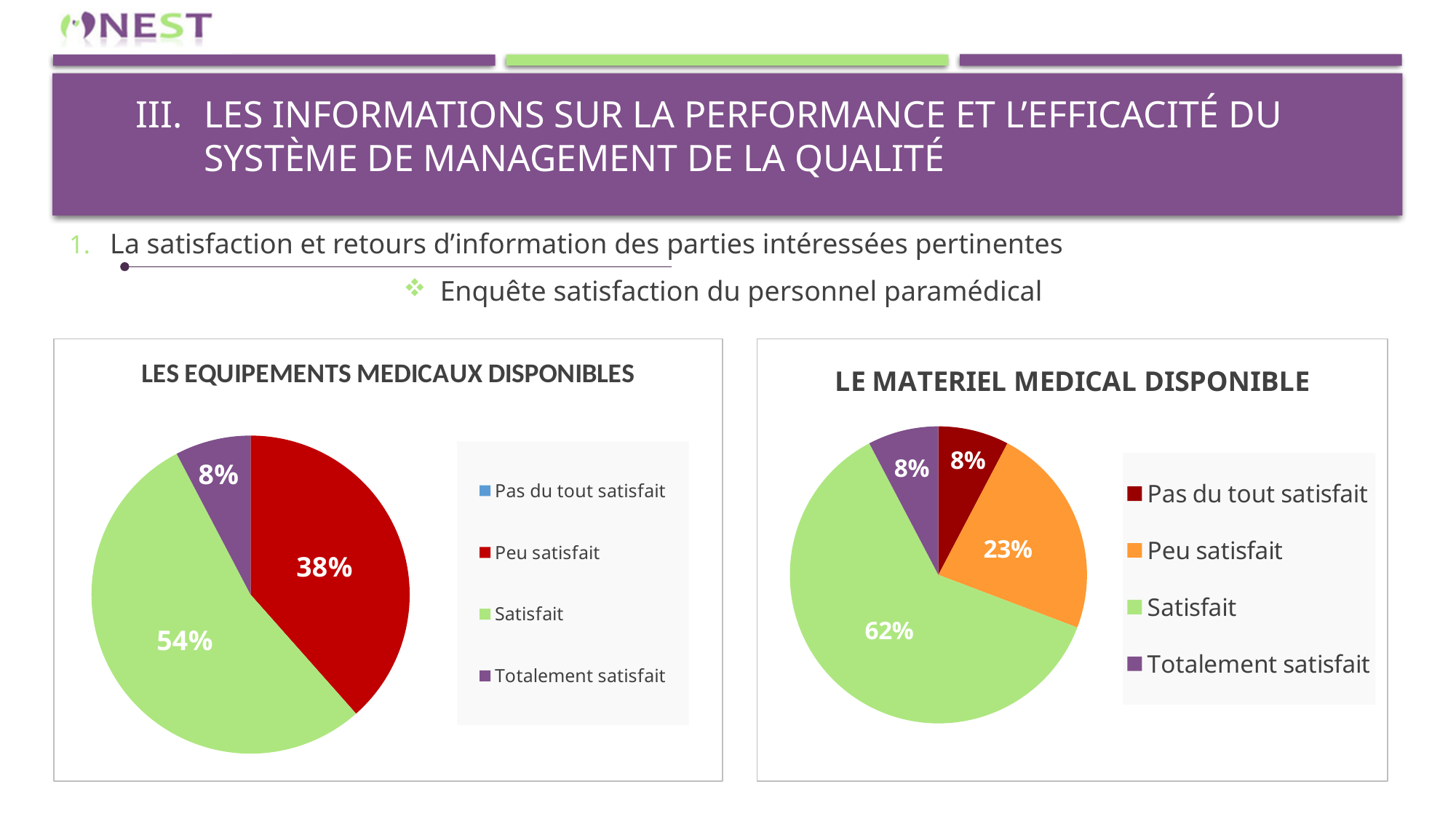
In the chart titled "LE MATERIEL MEDICAL DISPONIBLE", what share is labelled for Peu satisfait? 23% In the chart titled "LE MATERIEL MEDICAL DISPONIBLE", what share is labelled for Pas du tout satisfait? 8% In the chart titled "LES EQUIPEMENTS MEDICAUX DISPONIBLES", what share is labelled for Peu satisfait? 38% In the chart titled "LE MATERIEL MEDICAL DISPONIBLE", which category has the largest slice? Satisfait In the chart titled "LE MATERIEL MEDICAL DISPONIBLE", which is larger, the Peu satisfait slice or the Totalement satisfait slice? Peu satisfait What type of chart is the chart titled "LE MATERIEL MEDICAL DISPONIBLE"? Pie chart In the chart titled "LES EQUIPEMENTS MEDICAUX DISPONIBLES", how many entries does the legend list? 4 In the chart titled "LES EQUIPEMENTS MEDICAUX DISPONIBLES", which category has the largest slice? Satisfait In the chart titled "LE MATERIEL MEDICAL DISPONIBLE", what is the difference between the Satisfait and Peu satisfait shares? 39% In the chart titled "LE MATERIEL MEDICAL DISPONIBLE", what share is labelled for Satisfait? 62% In the chart titled "LES EQUIPEMENTS MEDICAUX DISPONIBLES", what share is labelled for Satisfait? 54% In the chart titled "LES EQUIPEMENTS MEDICAUX DISPONIBLES", what is the difference between the Satisfait and Peu satisfait shares? 16%